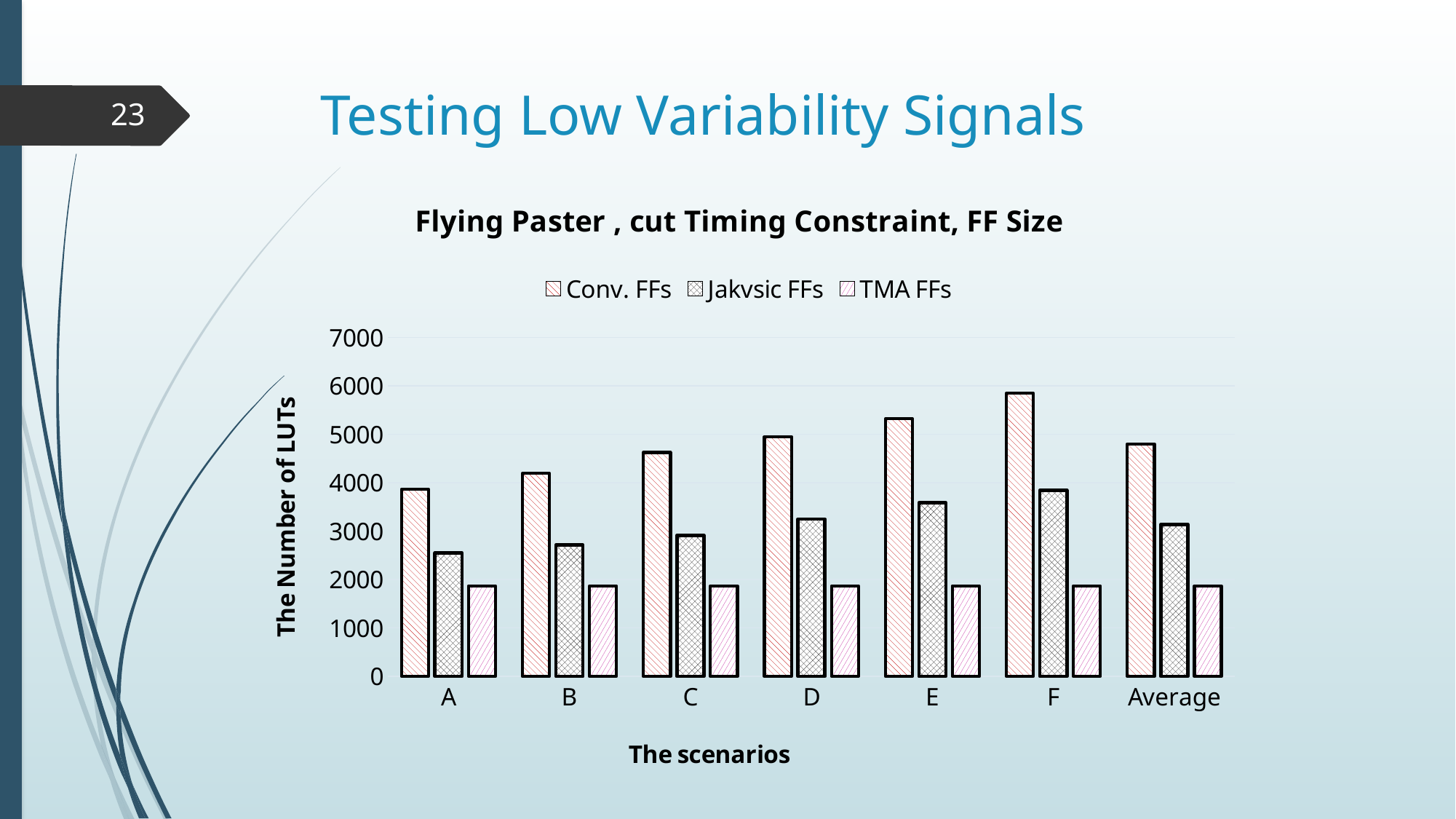
Is the value for TMA FFs in scenario D greater or less than 1000? greater Which scenario has the highest value for Jakvsic FFs? F What kind of chart is shown on the slide? bar chart How many scenario categories are shown on the x axis? 7 In scenario E, which is larger: Conv. FFs or Jakvsic FFs? Conv. FFs Do the Conv. FFs values rise or fall from scenario A to scenario F? rise What is the label of the y axis? The Number of LUTs Is the value for Conv. FFs in scenario F greater or less than 5000? greater Is the value for Jakvsic FFs in scenario A greater or less than 3000? less Which scenario has the highest value for Conv. FFs? F How many series does the legend list? 3 Which scenario has the lowest value for Conv. FFs? A